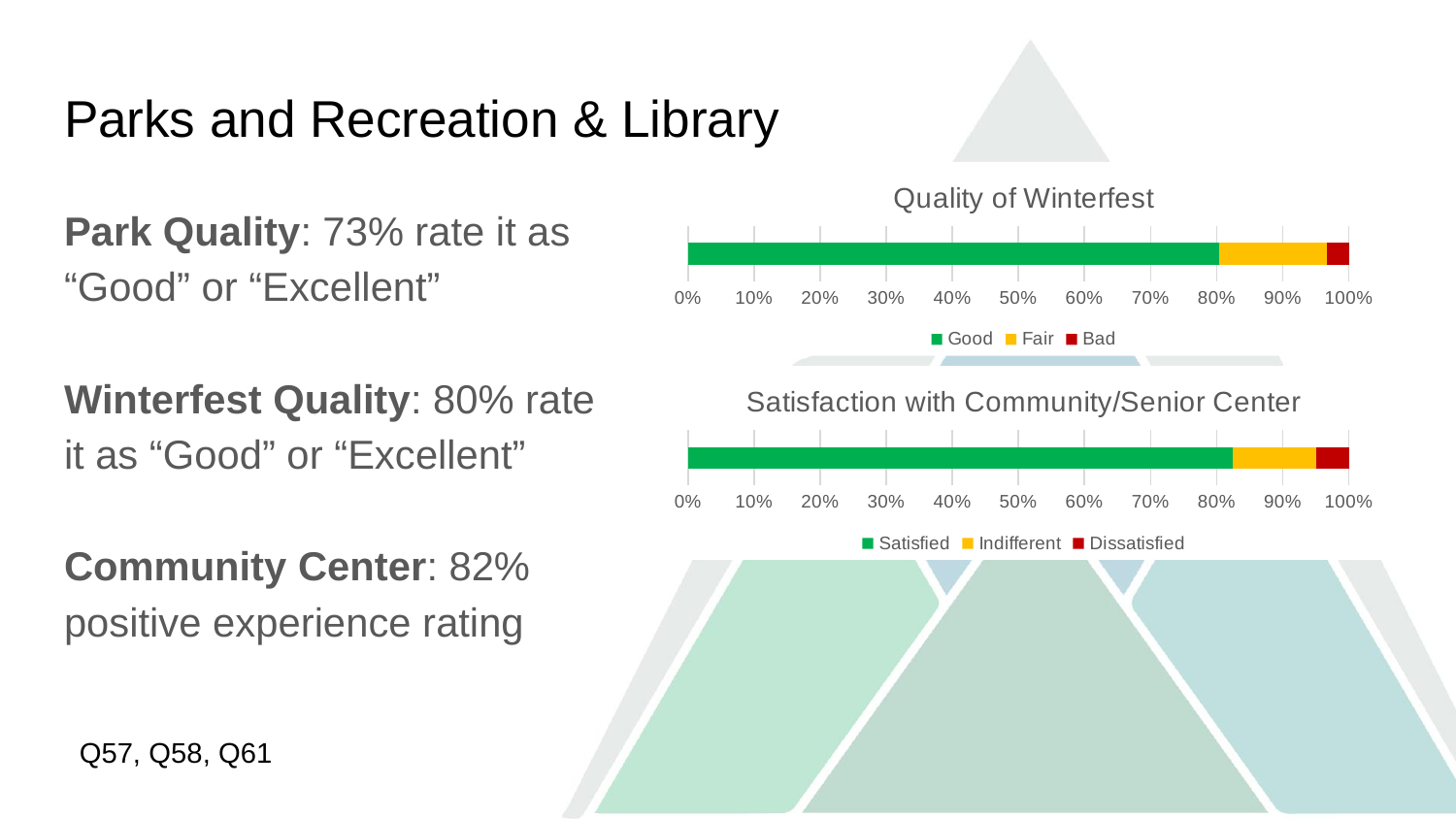
What kind of chart is the "Satisfaction with Community/Senior Center" chart? bar chart In the "Quality of Winterfest" chart, which segment is larger, Good or Fair? Good How many series does the legend of the "Satisfaction with Community/Senior Center" chart list? 3 In the "Satisfaction with Community/Senior Center" chart, which segment is the largest? Satisfied In the "Quality of Winterfest" chart, is the value for Good greater or less than 70%? greater In the "Quality of Winterfest" chart, which segment is the smallest? Bad How many series does the legend of the "Quality of Winterfest" chart list? 3 In the "Satisfaction with Community/Senior Center" chart, is the value for Satisfied greater or less than 80%? greater What are the legend entries of the "Quality of Winterfest" chart? Good, Fair, Bad What kind of chart is the "Quality of Winterfest" chart? bar chart In the "Satisfaction with Community/Senior Center" chart, which segment is larger, Indifferent or Dissatisfied? Indifferent In the "Quality of Winterfest" chart, is the value for Good greater or less than 90%? less